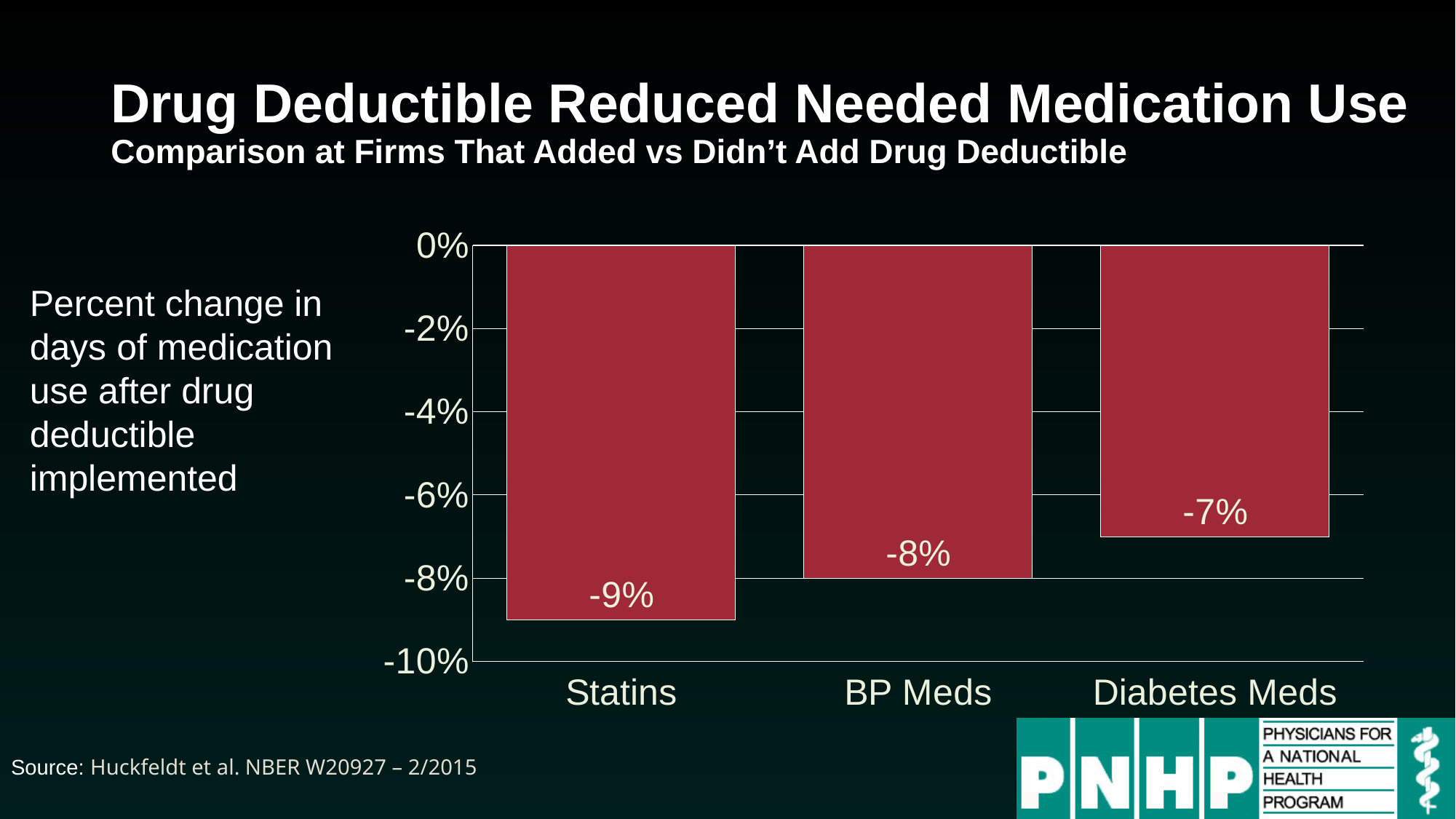
Which category had a larger decline in medication use, BP Meds or Diabetes Meds? BP Meds What type of chart is shown on the slide? Bar chart What is the percent change in days of medication use for Diabetes Meds? -7% What is the lowest value shown on the vertical axis? -10% What is the title of the slide containing the chart? Drug Deductible Reduced Needed Medication Use What is the percent change in days of medication use for Statins? -9% What is the percent change in days of medication use for BP Meds? -8% How many medication categories are shown in the chart? 3 What is the difference in percentage points between the change for Statins and the change for Diabetes Meds? 2 percentage points Which medication category shows the smallest decline in days of medication use? Diabetes Meds Which medication category shows the largest decline in days of medication use? Statins Do the bars become shorter or longer moving from Statins to Diabetes Meds along the x axis? Shorter